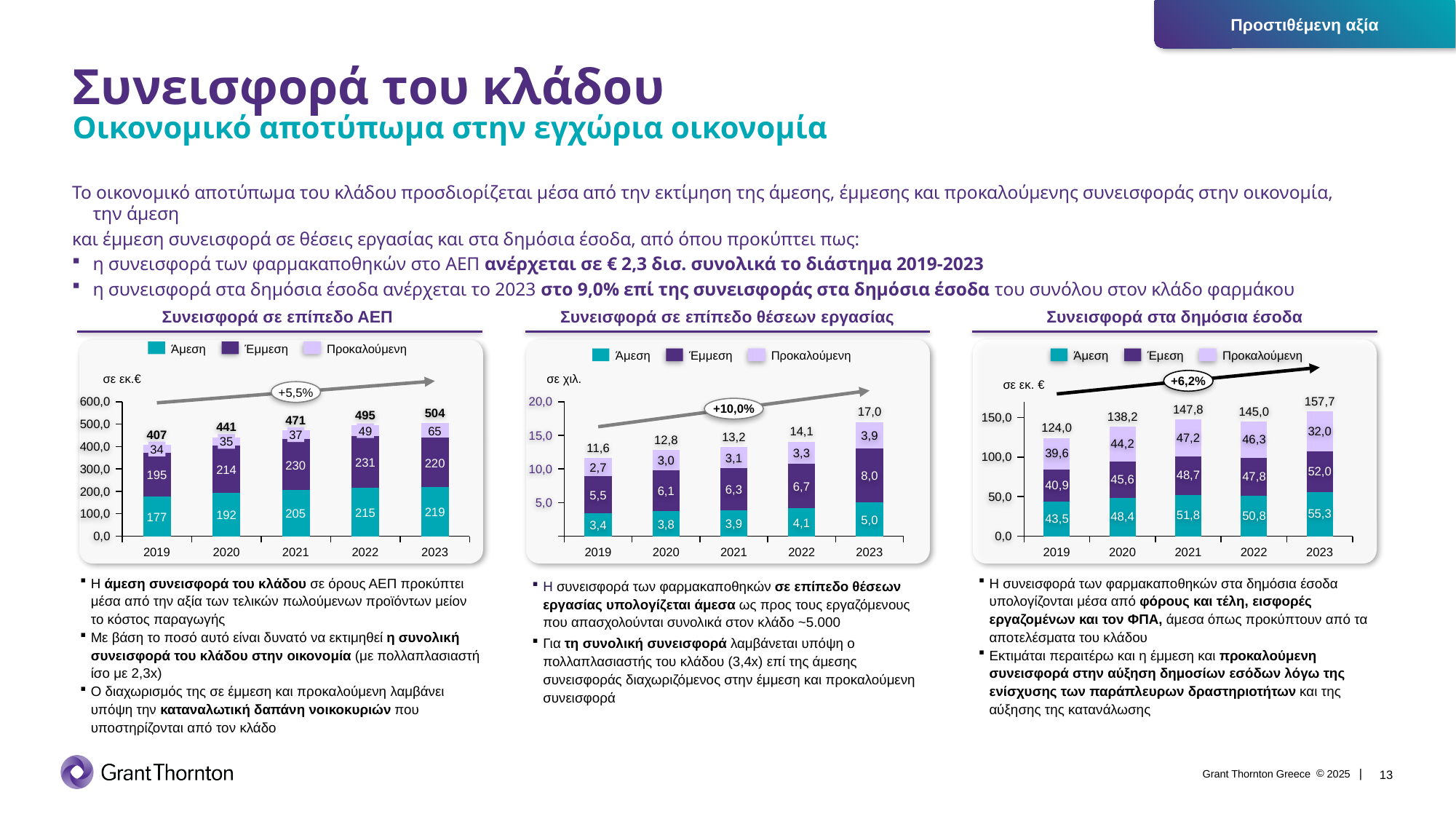
In the chart 'Συνεισφορά στα δημόσια έσοδα', what is the difference between the totals for 2023 and 2019? 33,7 In the chart 'Συνεισφορά σε επίπεδο ΑΕΠ', which year has the lowest total? 2019 In the chart 'Συνεισφορά σε επίπεδο θέσεων εργασίας', what is the value of the Έμμεση series for 2023? 8,0 How many series does the legend list in the chart 'Συνεισφορά στα δημόσια έσοδα'? 3 What kind of chart is 'Συνεισφορά σε επίπεδο ΑΕΠ'? stacked bar chart In the chart 'Συνεισφορά σε επίπεδο ΑΕΠ', what is the difference between the Προκαλούμενη values for 2023 and 2022? 16 In the chart 'Συνεισφορά σε επίπεδο ΑΕΠ', what is the value of the Άμεση series for 2021? 205 In the chart 'Συνεισφορά στα δημόσια έσοδα', which is larger: the Άμεση value for 2021 or the Άμεση value for 2022? 2021 In the chart 'Συνεισφορά σε επίπεδο θέσεων εργασίας', which year has the highest total? 2023 In the chart 'Συνεισφορά στα δημόσια έσοδα', what is the value of the Προκαλούμενη series for 2020? 44,2 In the chart 'Συνεισφορά σε επίπεδο θέσεων εργασίας', do the totals rise or fall from 2019 to 2023? rise In the chart 'Συνεισφορά σε επίπεδο ΑΕΠ', what is the total of the stacked bar for 2023? 504